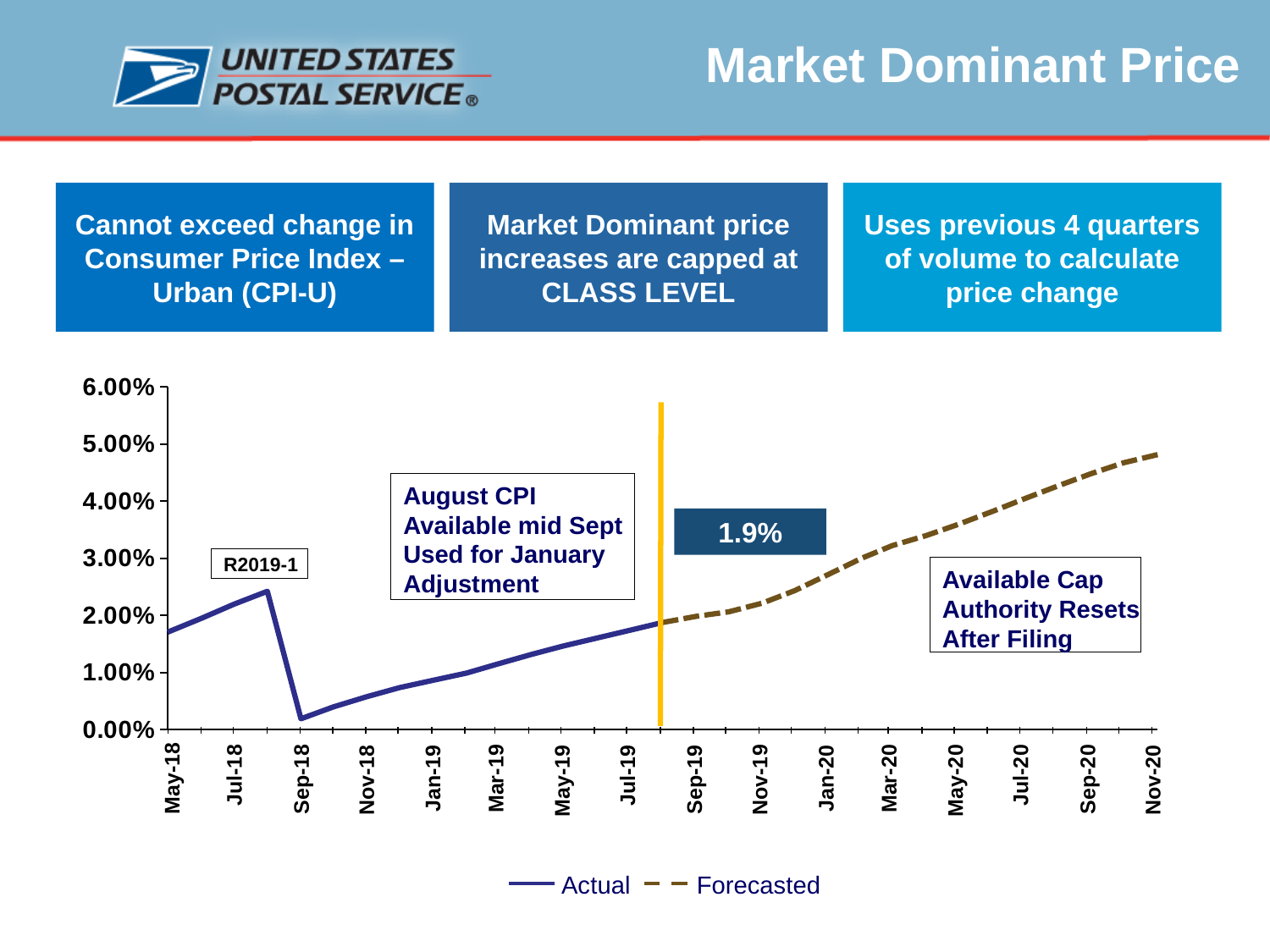
How many series does the chart legend list? 2 How many labels are shown on the x axis of the chart? 16 At which x-axis label does the Forecasted series reach its highest point? Nov-20 Is the value of the Forecasted series at Nov-20 greater or less than 4.00%? greater What are the two series named in the chart legend? Actual and Forecasted Is the value of the Actual series at Sep-18 greater or less than 1.00%? less Is the value of the Forecasted series at Jan-20 greater or less than 2.00%? greater Does the Forecasted series rise or fall from Sep-19 to Nov-20? rise What value is labeled on the chart at the vertical line where the Actual series ends and the Forecasted series begins? 1.9% What kind of chart is shown on the slide? line chart At which x-axis label does the Actual series reach its lowest point? Sep-18